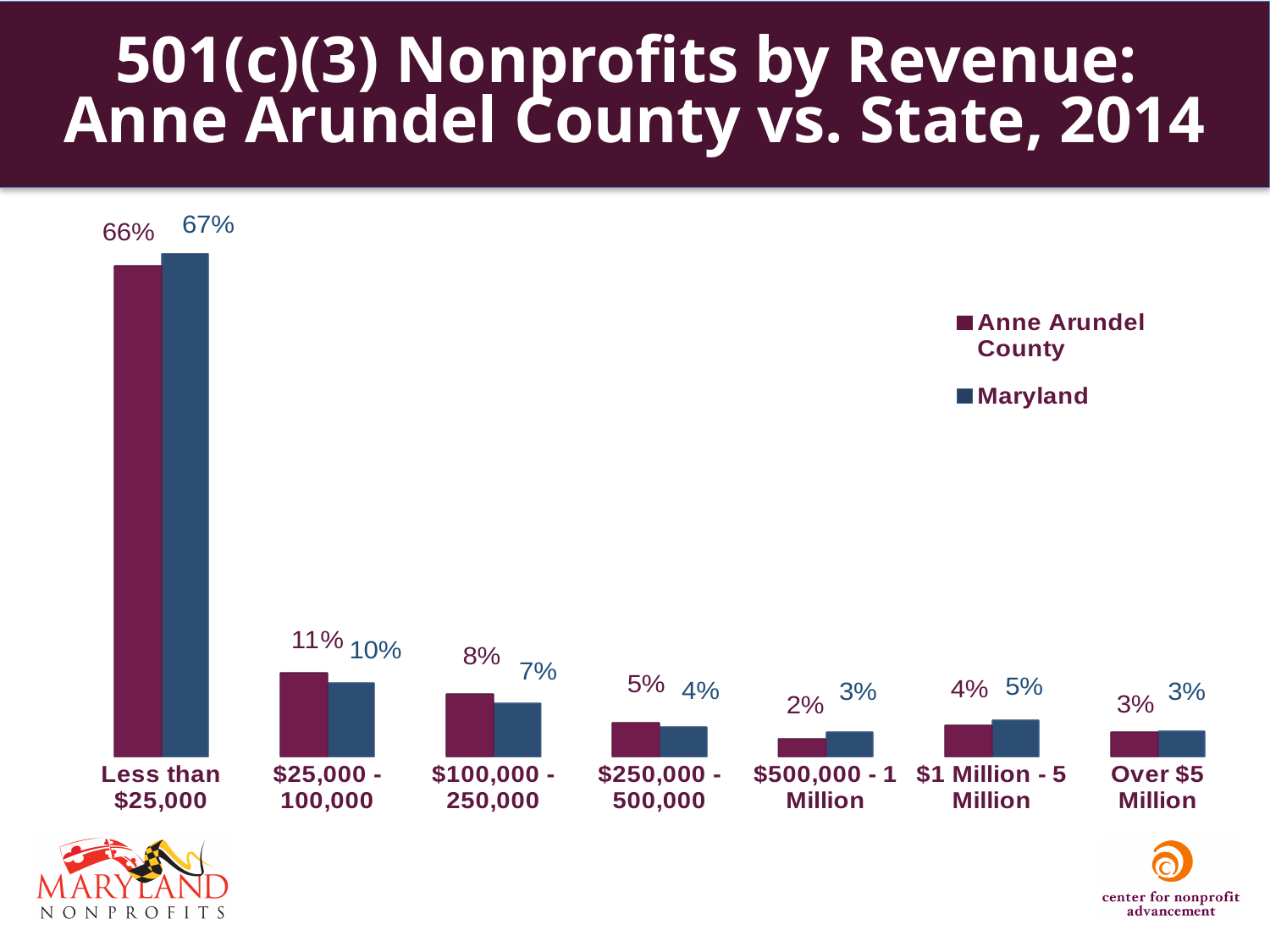
How many revenue categories are shown on the x axis? 7 What percentage of Anne Arundel County nonprofits have revenue of less than $25,000? 66% Which revenue category has the highest value for Maryland? Less than $25,000 Which series is shown in dark blue in the legend? Maryland Do the Anne Arundel County values generally rise or fall from the Less than $25,000 category to the $500,000 - 1 Million category? Fall What is the Anne Arundel County value for the $500,000 - 1 Million category? 2% In the $1 Million - 5 Million category, which series has the larger value, Anne Arundel County or Maryland? Maryland What is the difference between the Anne Arundel County and Maryland values for the $100,000 - 250,000 category? 1% What is the Maryland value for the $25,000 - 100,000 revenue category? 10% How many series does the legend list? 2 Which revenue category has the lowest value for Anne Arundel County? $500,000 - 1 Million What kind of chart is shown on the slide? Bar chart